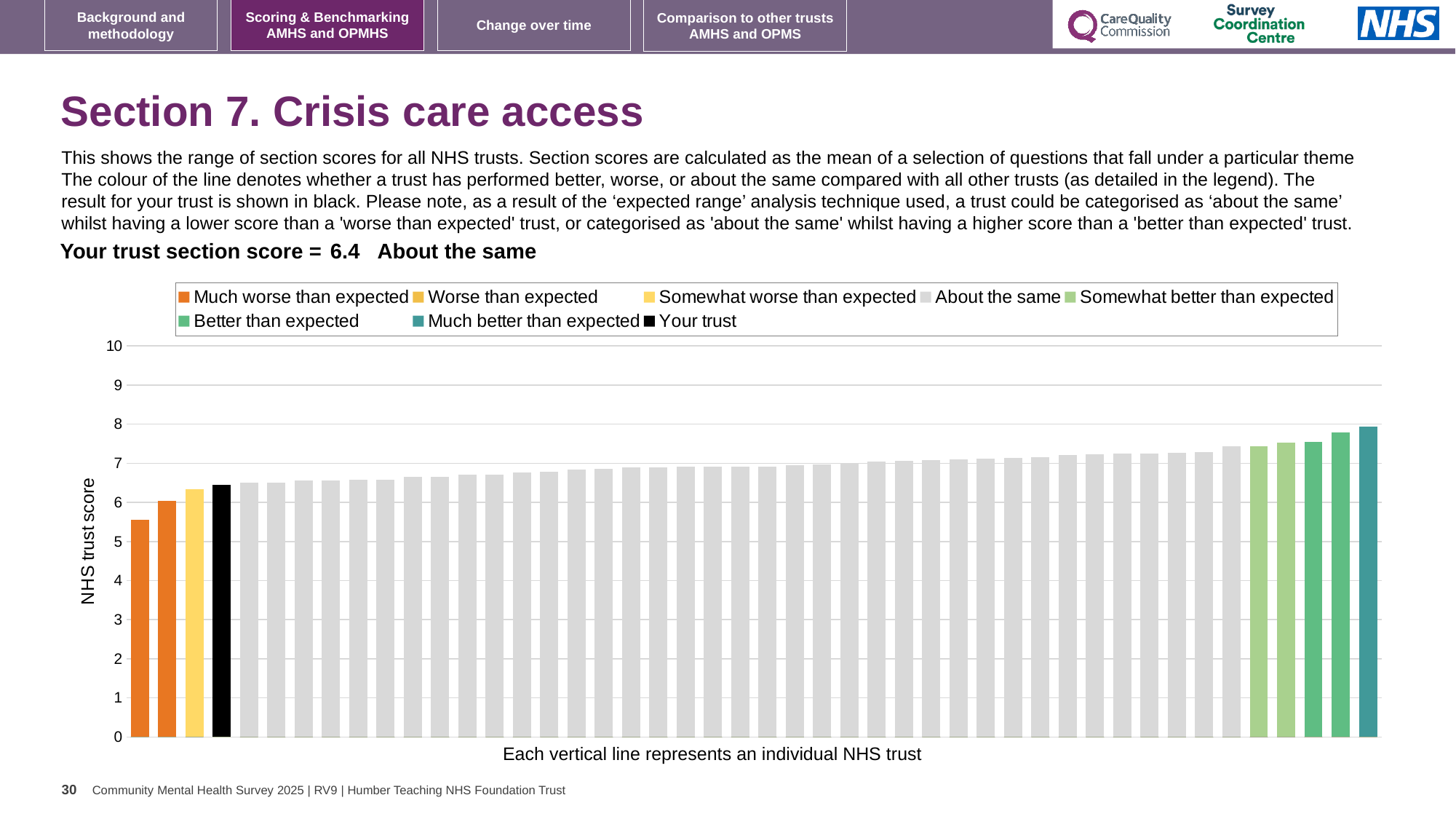
What is the section score for your trust shown on the slide? 6.4 Which category is your trust placed in for Section 7 Crisis care access? About the same Is the value of the highest bar in the chart greater or less than 7? greater How many bars are coloured as 'Much worse than expected'? 2 How many bars are coloured as 'Better than expected'? 2 What is the label on the vertical axis of the chart? NHS trust score How many entries does the chart legend list? 8 What kind of chart is shown on the slide? Bar chart Do the bar values rise or fall from left to right across the chart? Rise What does each vertical line in the chart represent, according to the axis caption? An individual NHS trust Is the value of the lowest bar in the chart greater or less than 6? less How many bars are coloured as 'Much better than expected'? 1